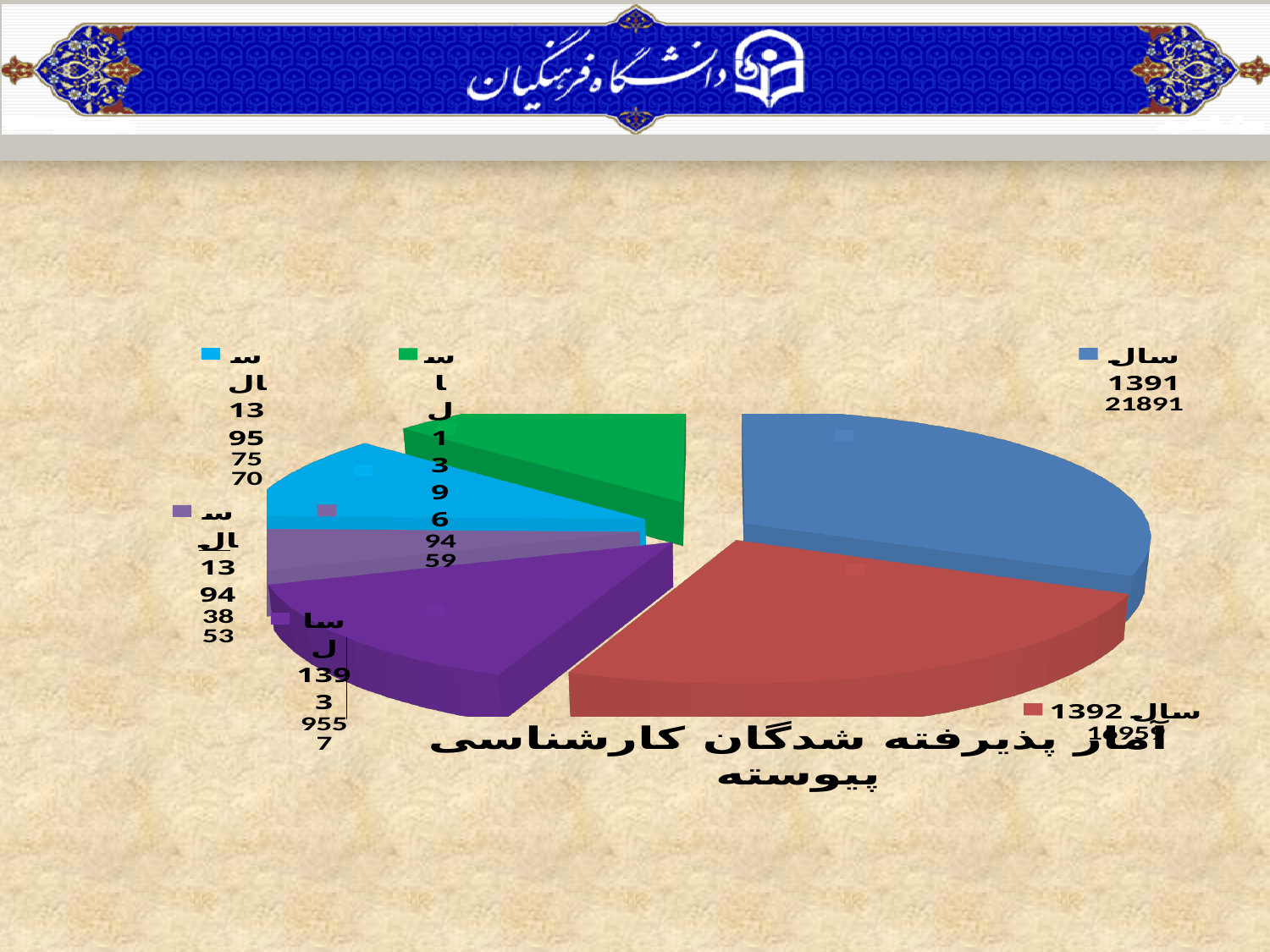
Which year has the largest slice of the pie? سال 1391 What is the value shown for سال 1393? 9557 What is the difference between the values for سال 1391 and سال 1393? 12334 What is the title of the chart? آمار پذیرفته شدگان کارشناسی پیوسته What kind of chart is shown on the slide? pie chart What is the value shown for سال 1395? 7570 How many slices does the pie chart have? 6 What is the value shown for سال 1396? 9459 Which year has the smallest slice of the pie? سال 1394 What is the value shown for سال 1394? 3853 What is the value shown for سال 1391? 21891 Which is larger, the value for سال 1395 or سال 1396? سال 1396